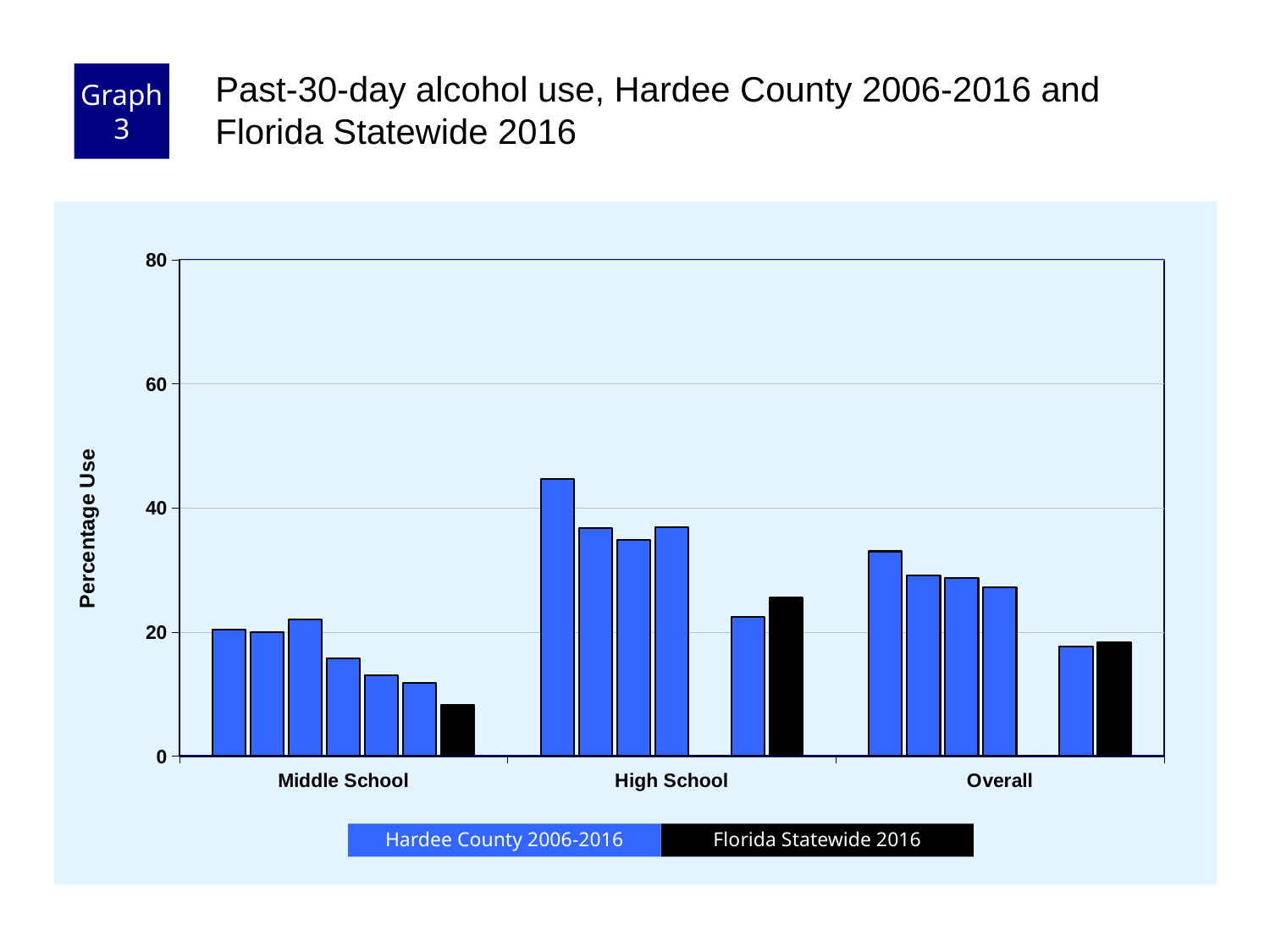
What is the label of the vertical axis? Percentage Use How many school-level categories are shown on the x axis? 3 Is the highest Hardee County bar for High School greater or less than 40? greater How many series does the legend list? 2 For which category is the Florida Statewide 2016 value highest? High School Is the Florida Statewide 2016 value for Middle School greater or less than 20? less For which category is the Florida Statewide 2016 value lowest? Middle School Do the Hardee County 2006-2016 bars for Middle School generally rise or fall from left to right? fall Is the highest Hardee County bar for Overall greater or less than 40? less What kind of chart is shown on the slide? bar chart Which colour represents Florida Statewide 2016 in the legend? black